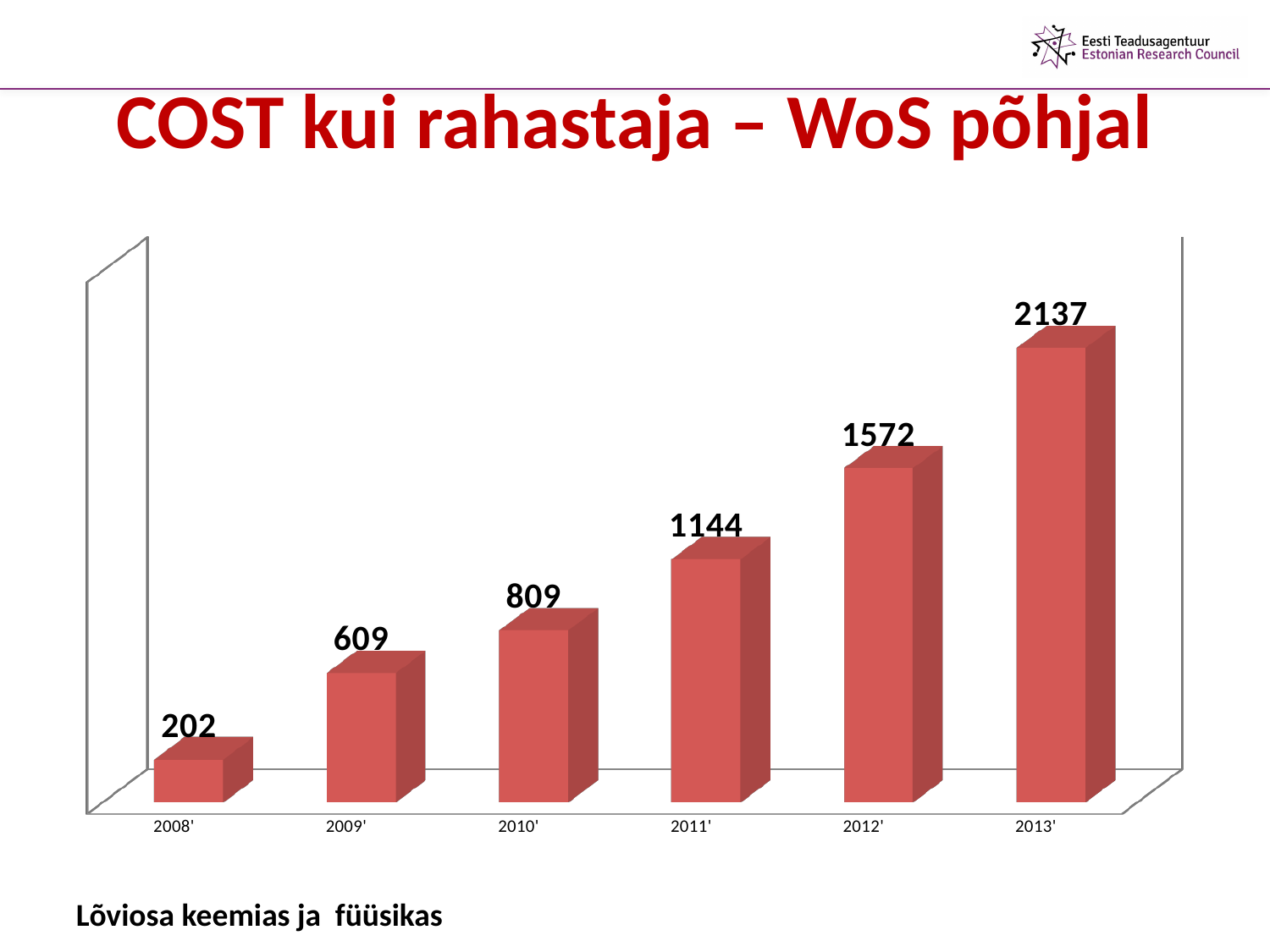
What is the title of the slide containing the chart? COST kui rahastaja – WoS põhjal How many years are shown on the x axis? 6 What is the value for 2012'? 1572 Which year has the lowest value? 2008' What is the value for 2008'? 202 What kind of chart is shown on the slide? bar chart Do the values rise or fall from 2008' to 2013'? rise Which is larger, the value for 2009' or the value for 2011'? 2011' What is the difference between the values for 2013' and 2012'? 565 What is the value for 2010'? 809 Which year has the highest value? 2013' What is the difference between the values for 2011' and 2010'? 335